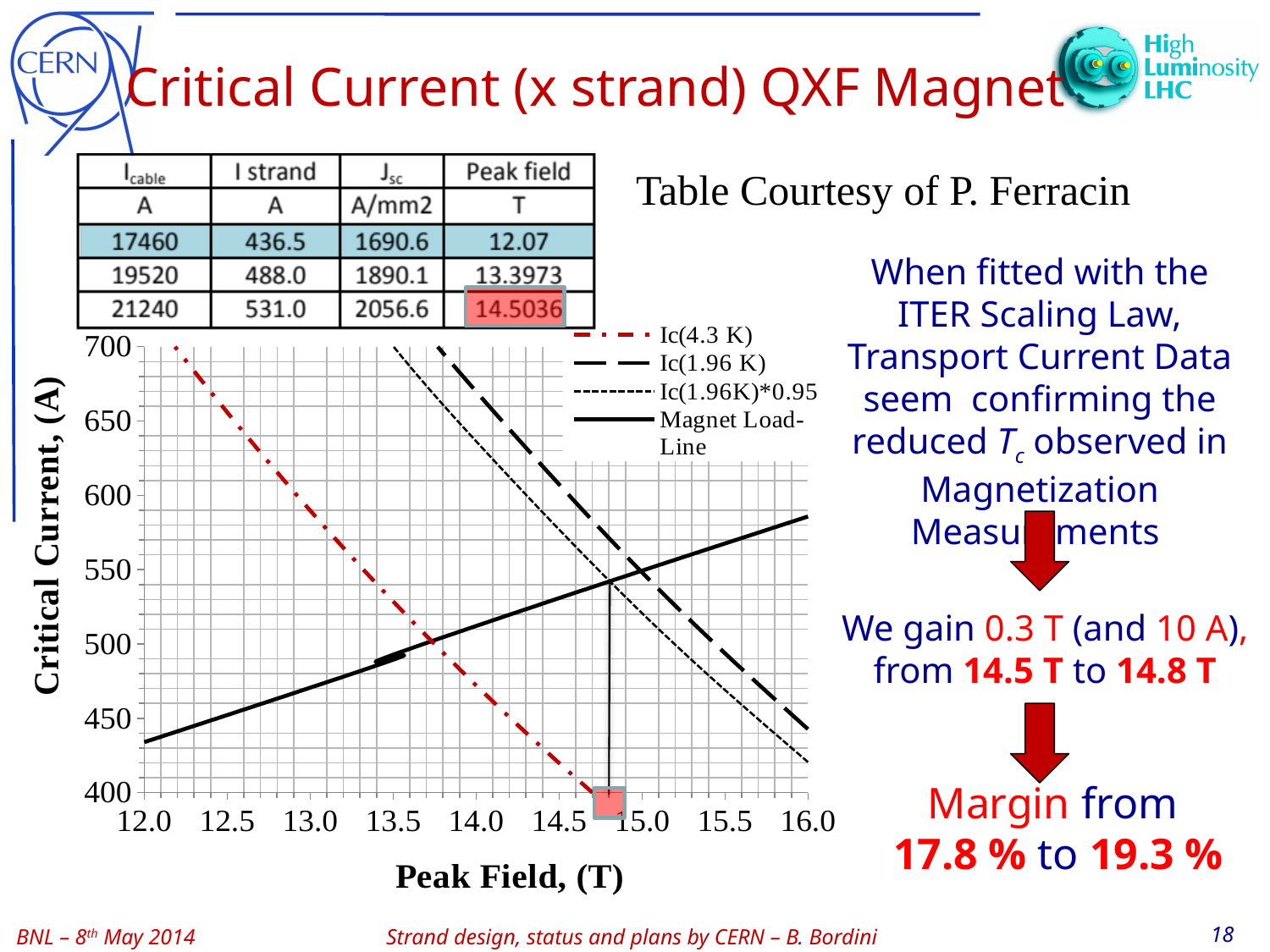
At 16.0 T, which is larger: the Magnet Load-Line or Ic(1.96 K)? Magnet Load-Line Does the Magnet Load-Line rise or fall as Peak Field increases? rise How many series does the chart legend list? 4 Is the value of Ic(1.96 K) at 14.0 T greater or less than 650? greater At 12.5 T, which is larger: Ic(4.3 K) or the Magnet Load-Line? Ic(4.3 K) Is the value of the Magnet Load-Line at 16.0 T greater or less than 550? greater Is the value of Ic(1.96K)*0.95 at 16.0 T greater or less than 450? less What is the title of the y axis of the chart? Critical Current, (A) Does the Ic(4.3 K) curve rise or fall as Peak Field increases? fall What is the title of the x axis of the chart? Peak Field, (T) What kind of chart is shown on the slide? line chart